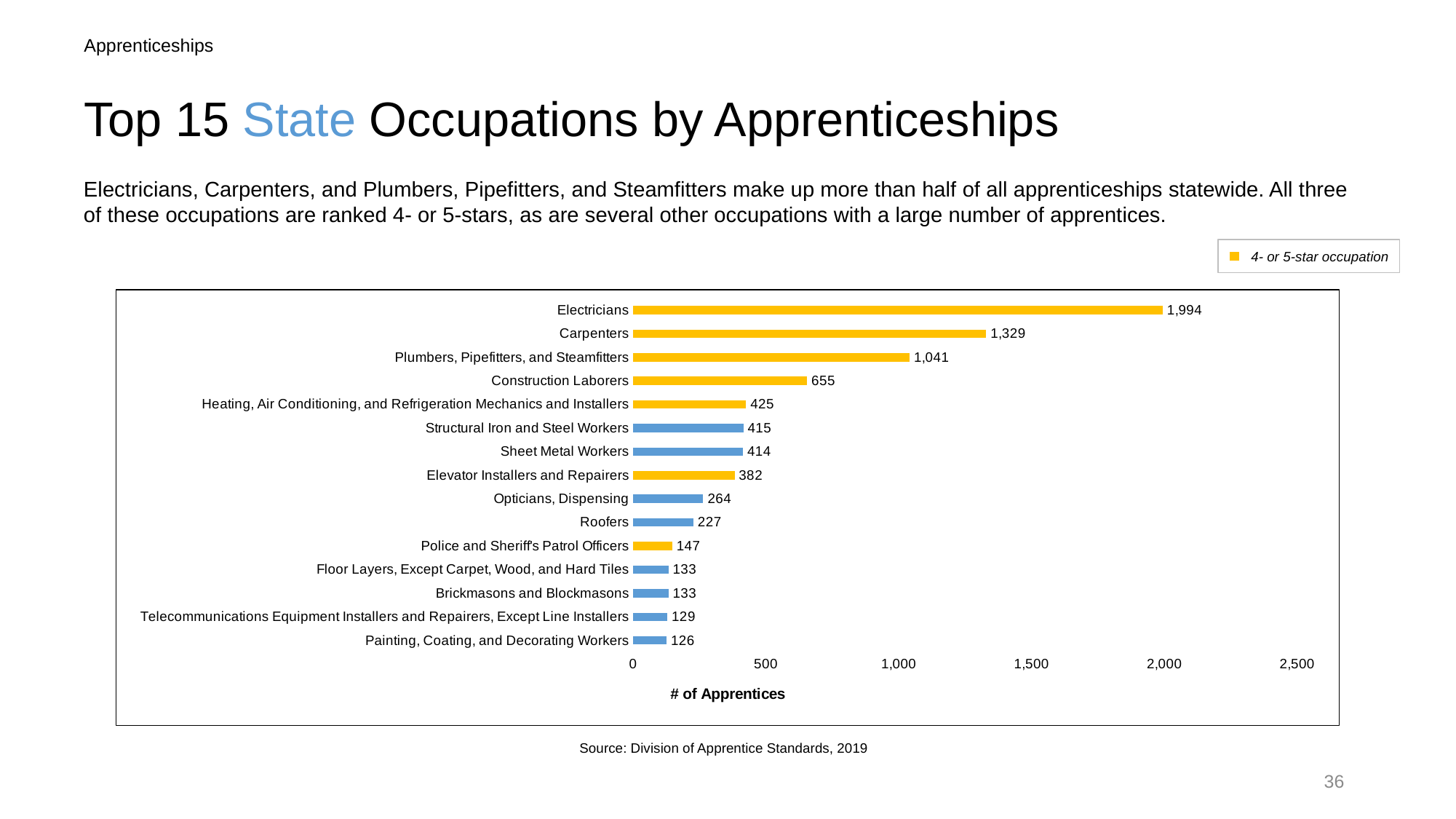
What kind of chart is shown on the slide? Bar chart Which has more apprentices, Sheet Metal Workers or Elevator Installers and Repairers? Sheet Metal Workers What is the label of the horizontal axis? # of Apprentices What is the difference in apprentices between Electricians and Carpenters? 665 Which occupation has the highest number of apprentices? Electricians How many occupations are shown in the chart? 15 Is the value for Plumbers, Pipefitters, and Steamfitters greater or less than 1,000? greater How many apprentices are there for Construction Laborers? 655 What does the yellow bar colour indicate according to the legend? 4- or 5-star occupation How many apprentices are there for Electricians? 1,994 How many apprentices are there for Roofers? 227 Which occupation has the lowest number of apprentices? Painting, Coating, and Decorating Workers